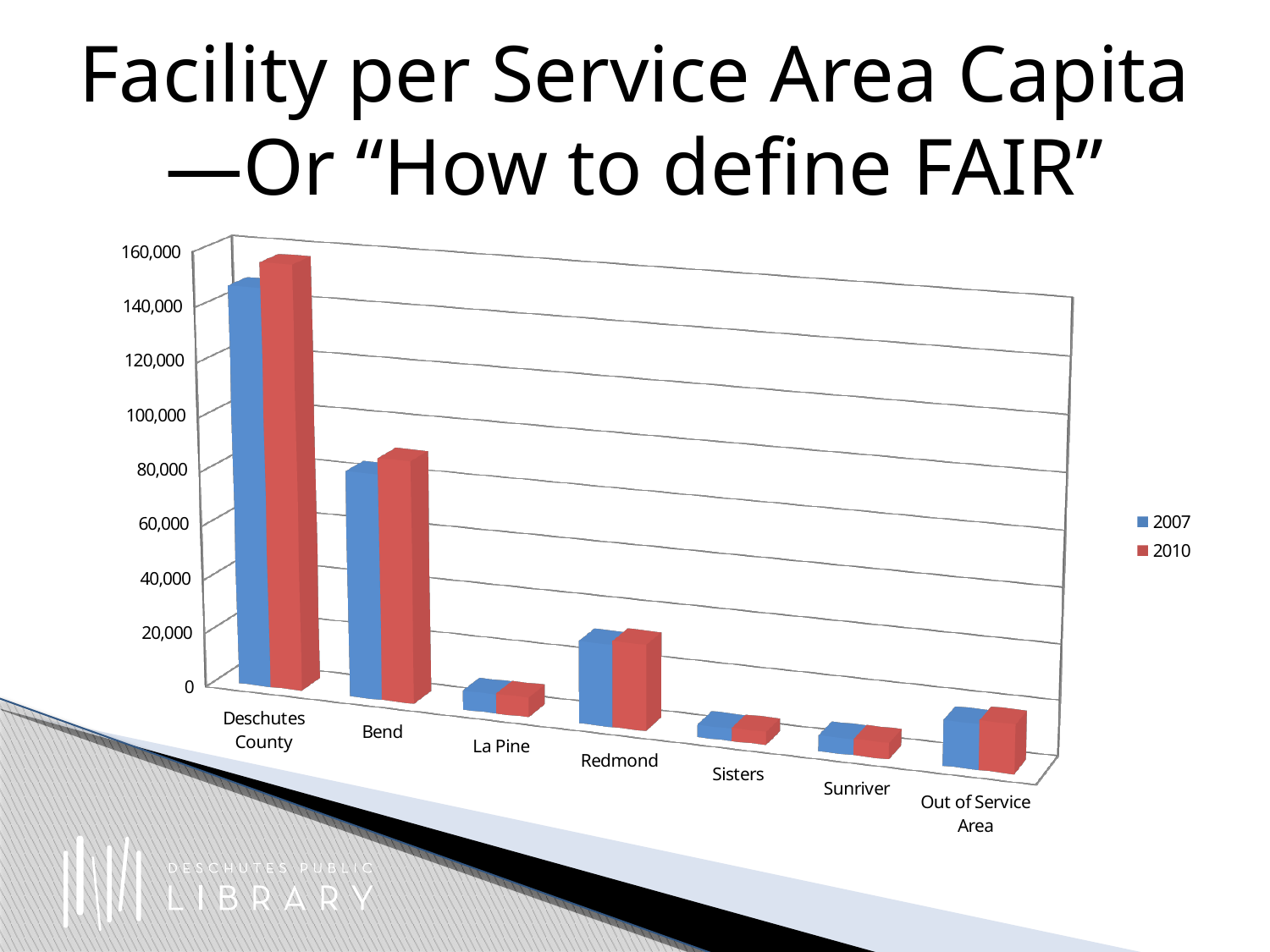
Is the 2007 value for Deschutes County greater or less than 120,000? greater What kind of chart is shown on the slide? bar chart How many series does the chart's legend list? 2 Which category has the highest values in the chart? Deschutes County Is the 2007 value for Bend greater or less than 60,000? greater Which two series are listed in the chart's legend? 2007 and 2010 What is the highest value shown on the chart's vertical axis? 160,000 How many categories are shown along the x axis of the chart? 7 Which is larger, the 2007 value for Redmond or the 2007 value for La Pine? Redmond Is the 2010 value for Redmond greater or less than 40,000? less Which is larger, the 2010 value for Deschutes County or the 2010 value for Bend? Deschutes County